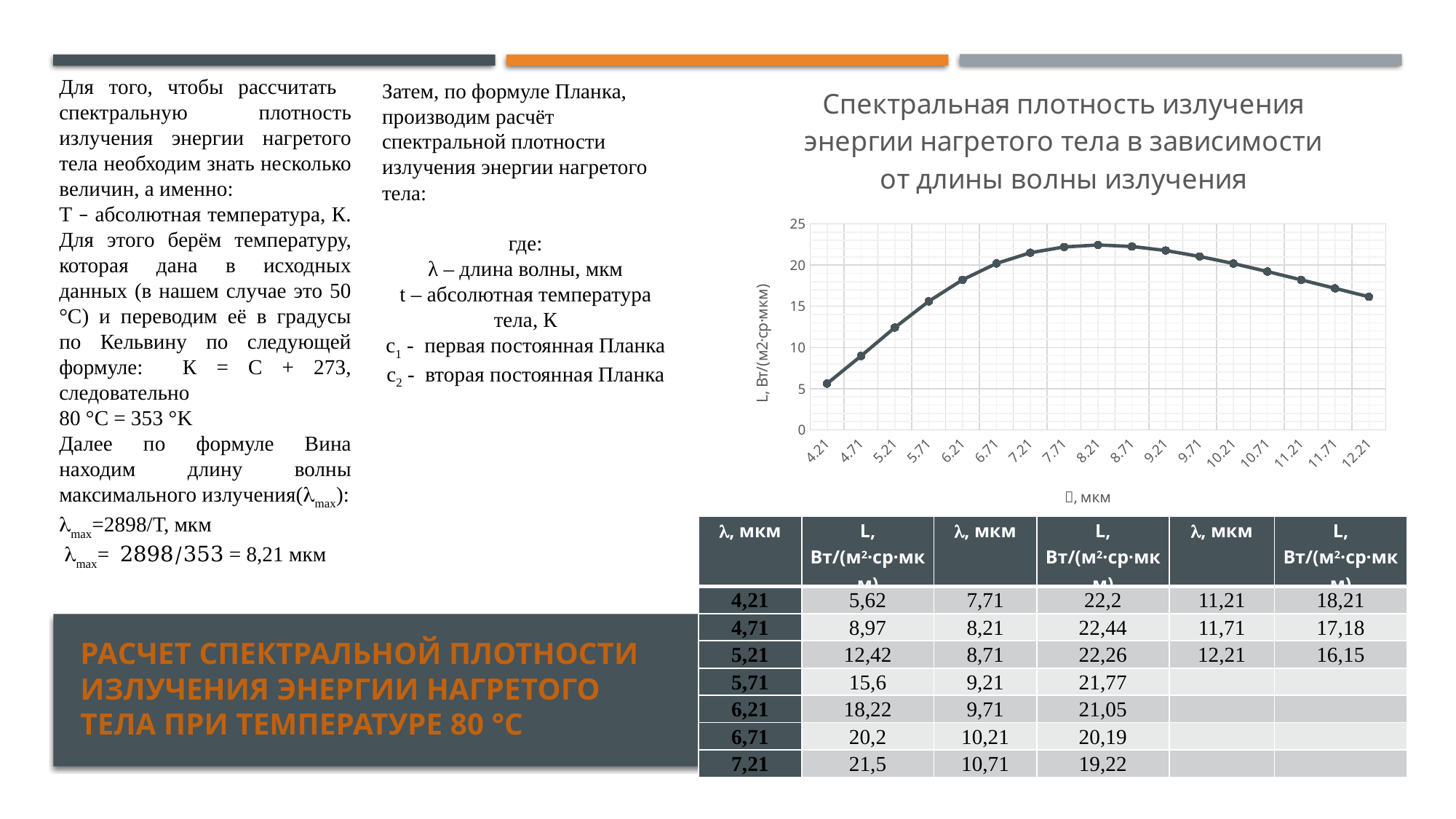
Is the value for λ = 8,21 мкм greater or less than 20? greater How many data points are plotted on the line chart? 17 According to the table on the slide, what is the value of L at λ = 8,21 мкм? 22,44 At which wavelength (λ, мкм) is the plotted value lowest? 4,21 Which is larger, the value at λ = 5,21 мкм or at λ = 10,21 мкм? 10,21 What is the label of the vertical axis of the chart? L, Вт/(м2·ср·мкм) What is the title of the chart? Спектральная плотность излучения энергии нагретого тела в зависимости от длины волны излучения Is the value for λ = 4,21 мкм greater or less than 10? less Does the plotted value rise or fall between λ = 9,21 and λ = 12,21 мкм? fall Does the plotted value rise or fall between λ = 4,21 and λ = 7,21 мкм? rise What kind of chart is shown on the slide? line chart Is the value for λ = 12,21 мкм greater or less than 20? less